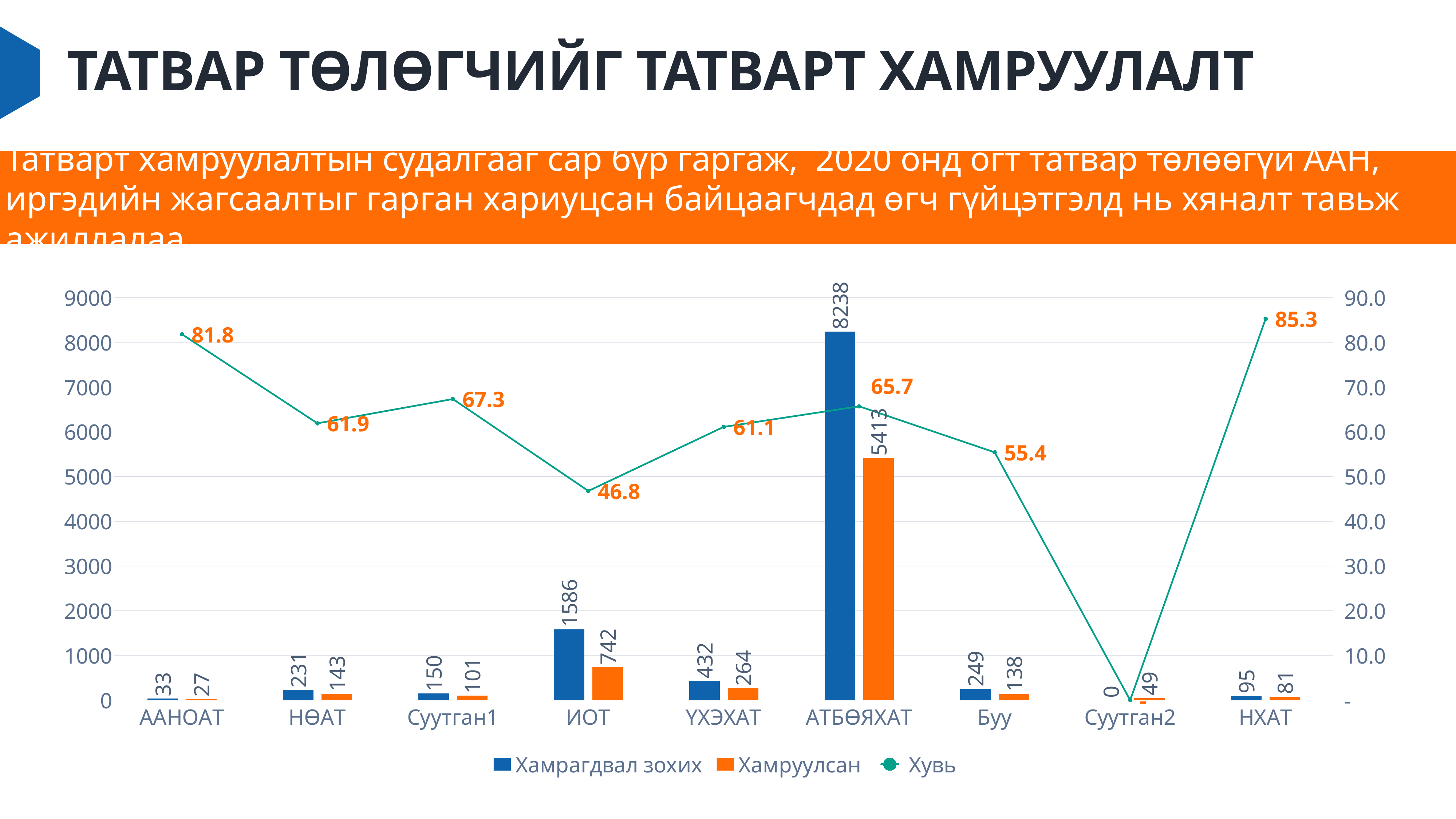
What is the difference between Хамрагдвал зохих and Хамруулсан for АТБӨЯХАТ? 2825 Which category has the highest Хамрагдвал зохих value? АТБӨЯХАТ What is the value of Хамрагдвал зохих for АТБӨЯХАТ? 8238 What kind of chart is shown on the slide? Combined bar and line chart Which category has the lowest Хамрагдвал зохих value? Суутган2 What is the Хувь value for Буу? 55.4 What is the Хувь value for НХАТ? 85.3 What is the Хувь value for ИОТ? 46.8 How many categories are shown on the x axis? 9 What is the value of Хамруулсан for ИОТ? 742 Which is larger, the Хамруулсан value for НӨАТ or for Буу? НӨАТ How many series does the legend list? 3